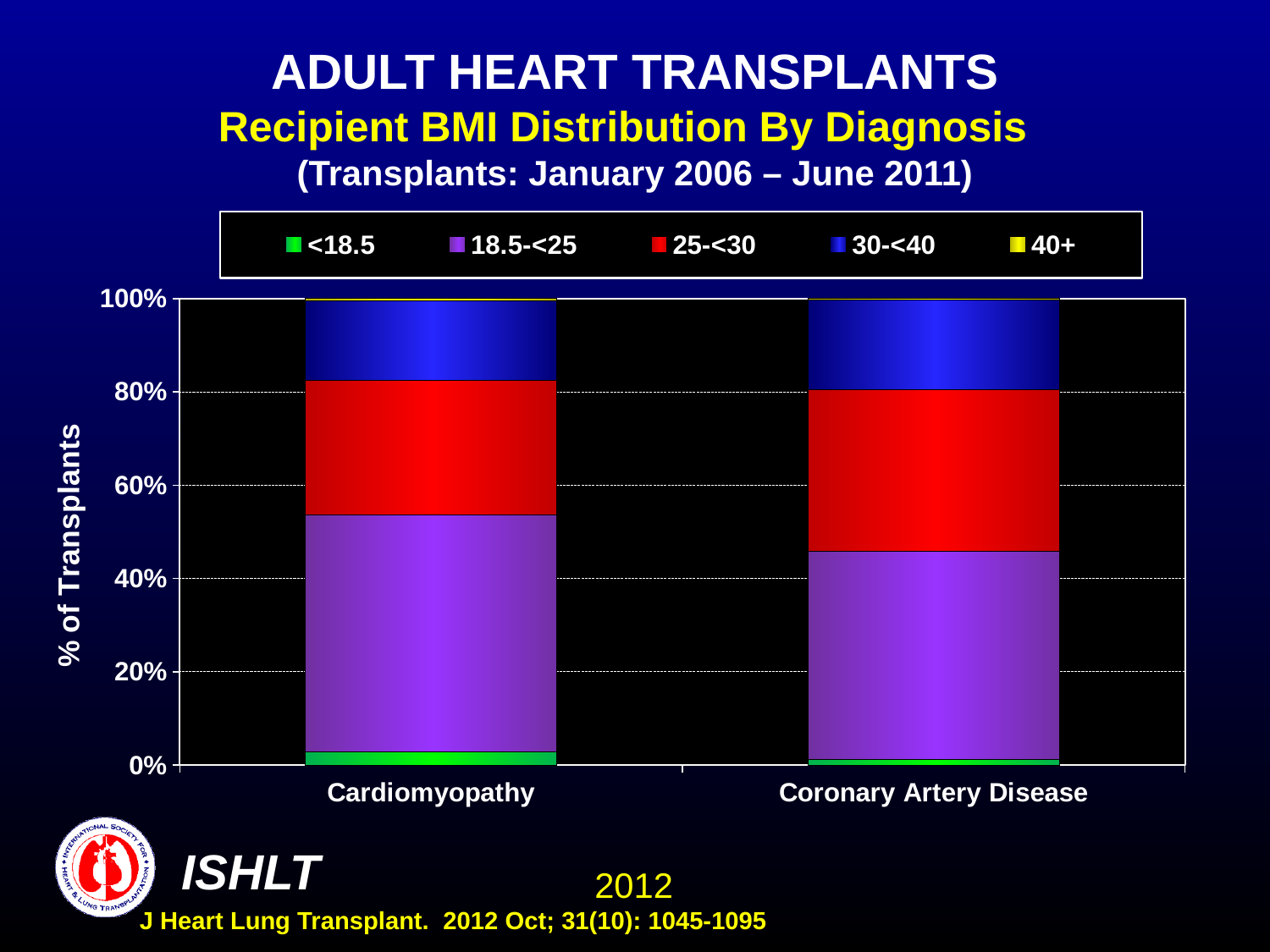
Which BMI group makes up the largest share of the Coronary Artery Disease bar? 18.5-<25 How many BMI groups does the legend list? 5 How many diagnosis categories are shown on the x axis? 2 Is the 18.5-<25 share larger for Cardiomyopathy or for Coronary Artery Disease? Cardiomyopathy Is the 25-<30 share for Coronary Artery Disease greater or less than 20%? greater What is the label on the y axis? % of Transplants Is the 25-<30 share larger for Cardiomyopathy or for Coronary Artery Disease? Coronary Artery Disease What kind of chart is shown on the slide? Stacked bar chart Is the 18.5-<25 share for Coronary Artery Disease greater or less than 60%? less Is the 18.5-<25 share for Cardiomyopathy greater or less than 40%? greater What value does each stacked bar total on the y axis? 100% Which BMI group makes up the largest share of the Cardiomyopathy bar? 18.5-<25